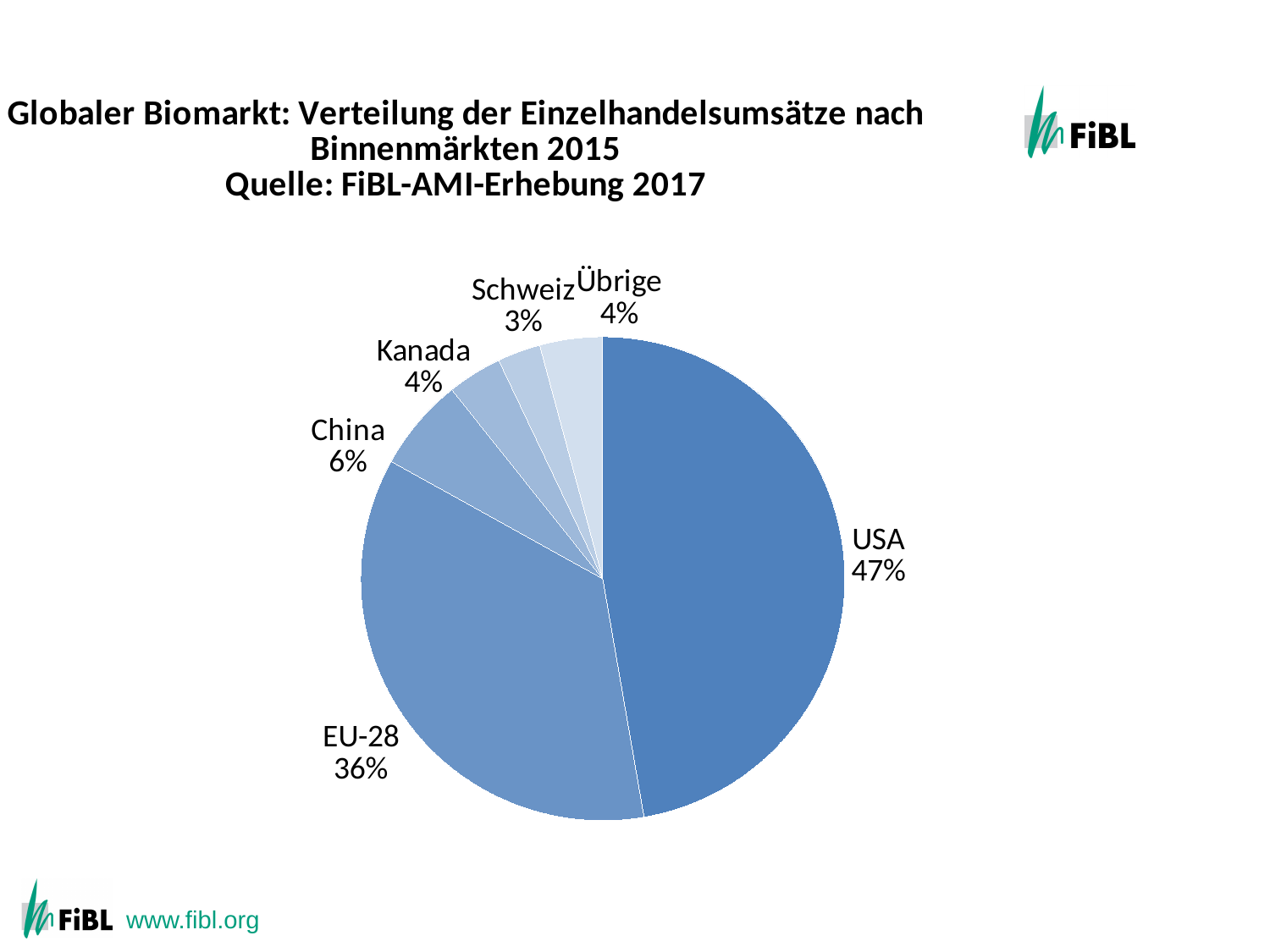
How many slices does the pie chart have? 6 Which is larger, the share for China or the share for Kanada? China What source is cited in the chart title? FiBL-AMI-Erhebung 2017 What is the combined share of Kanada and Übrige? 8% What share of the pie does the USA hold? 47% What is the difference in percentage points between the USA and EU-28 shares? 11 Which category has the largest slice of the pie? USA Which category has the smallest slice of the pie? Schweiz What share of the pie does China hold? 6% What share of the pie does EU-28 hold? 36% What share of the pie does Schweiz hold? 3% What kind of chart is shown on the slide? Pie chart